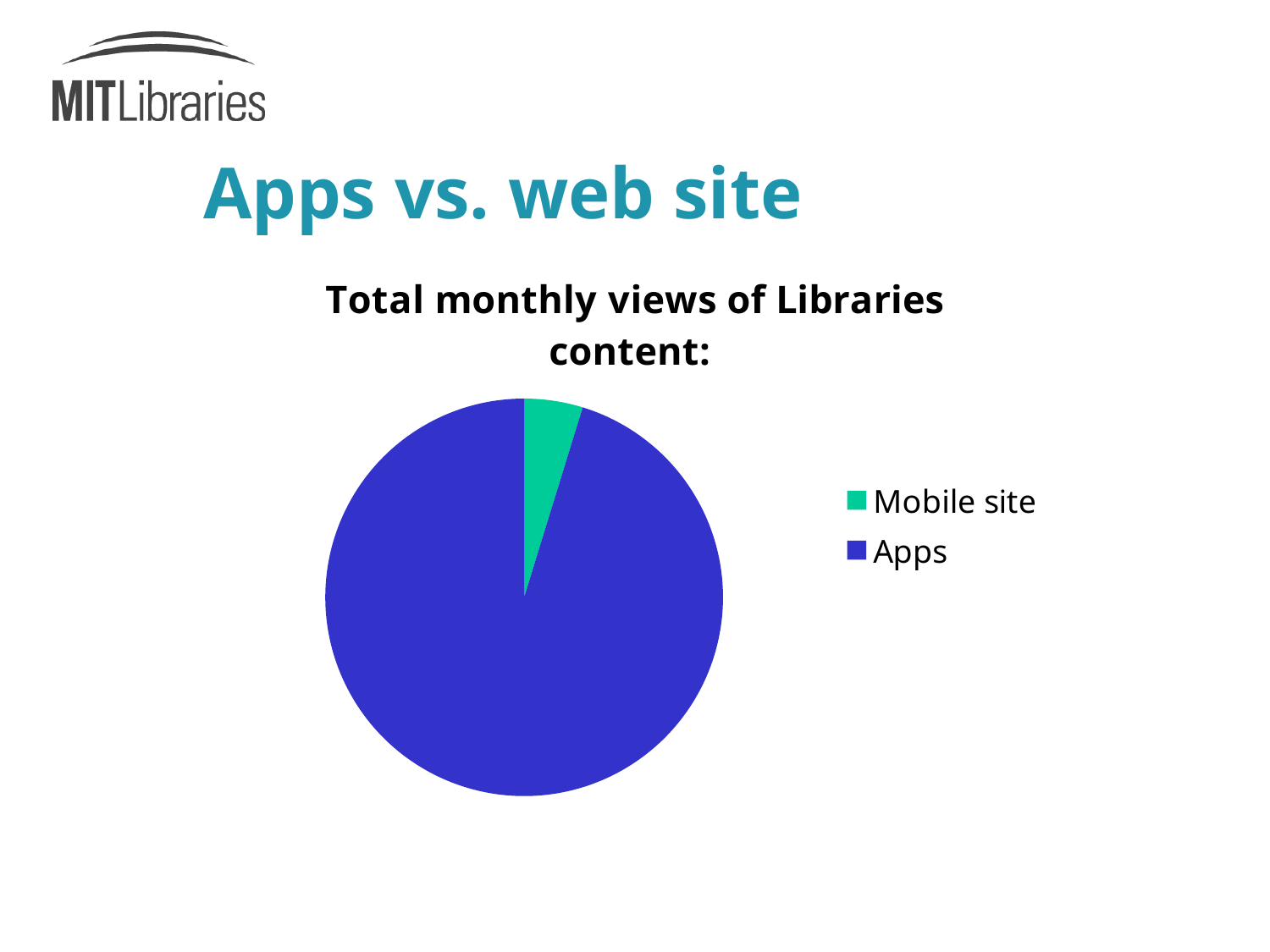
How many entries does the legend list? 2 How many slices does the pie chart have? 2 Which legend entry is shown in green? Mobile site Which category has the largest slice of the pie? Apps What is the title of the chart? Total monthly views of Libraries content: Which category has the smallest slice of the pie? Mobile site What kind of chart is shown on the slide? pie chart Which is larger, the slice for Apps or the slice for Mobile site? Apps